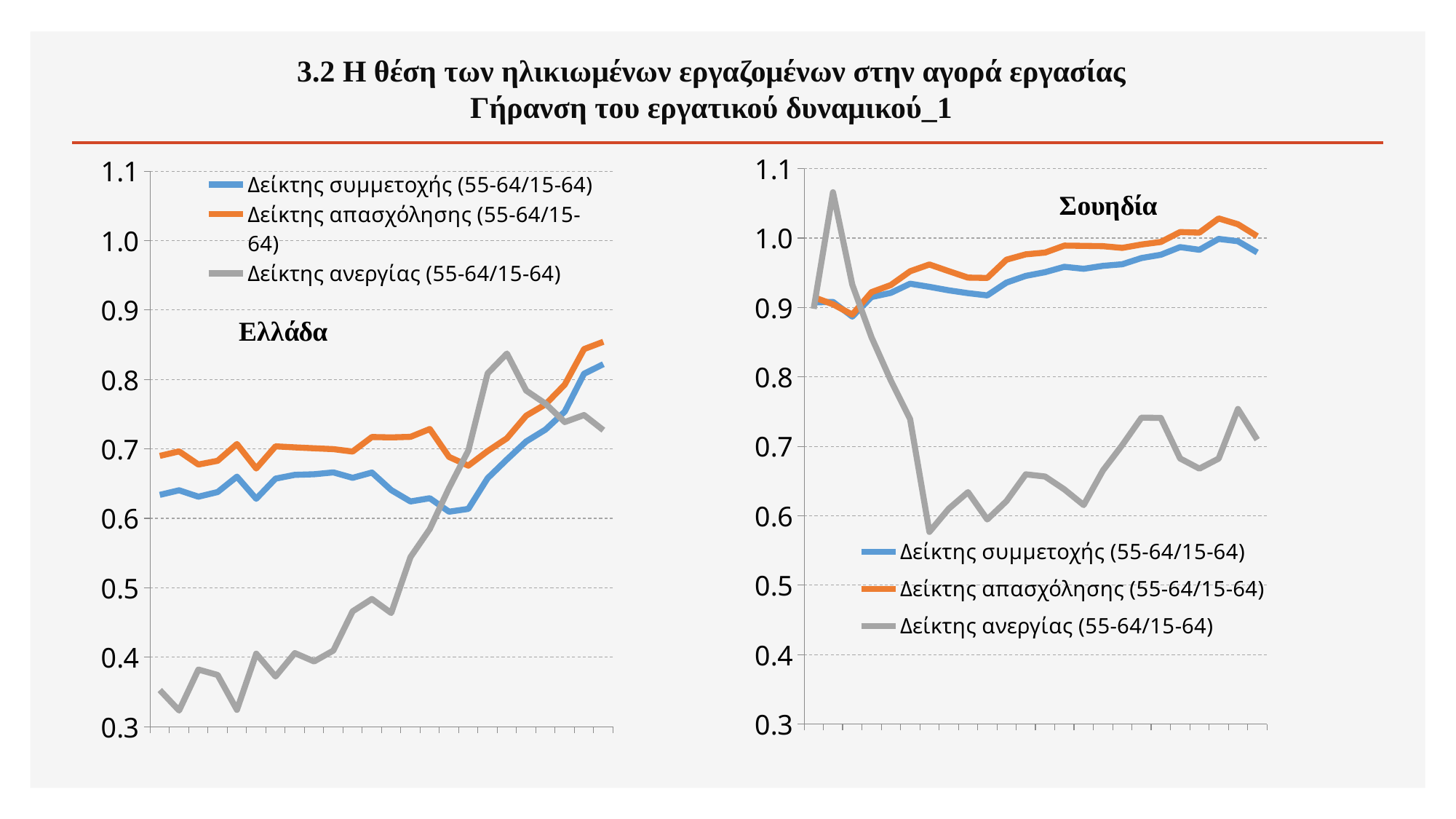
In the Ελλάδα chart, is the first value of the Δείκτης ανεργίας (55-64/15-64) line greater or less than 0.4? less In the Ελλάδα chart, is the last value of the Δείκτης απασχόλησης (55-64/15-64) line greater or less than 0.8? greater Which colour is used for the Δείκτης ανεργίας (55-64/15-64) series in both charts? grey In the Σουηδία chart, is the peak value of the Δείκτης ανεργίας (55-64/15-64) line greater or less than 1.0? greater In the Σουηδία chart, does the Δείκτης ανεργίας (55-64/15-64) line rise or fall overall from left to right? fall How many series does the legend of the Σουηδία chart list? 3 In the Σουηδία chart, does the Δείκτης συμμετοχής (55-64/15-64) line rise or fall overall from left to right? rise In the Ελλάδα chart, at the leftmost point, which is higher: Δείκτης απασχόλησης (55-64/15-64) or Δείκτης συμμετοχής (55-64/15-64)? Δείκτης απασχόλησης (55-64/15-64) What kind of chart is the Ελλάδα chart on the left? line chart In the Ελλάδα chart, does the Δείκτης ανεργίας (55-64/15-64) line rise or fall overall from left to right? rise In the Σουηδία chart, at the rightmost point, which is higher: Δείκτης απασχόλησης (55-64/15-64) or Δείκτης ανεργίας (55-64/15-64)? Δείκτης απασχόλησης (55-64/15-64)